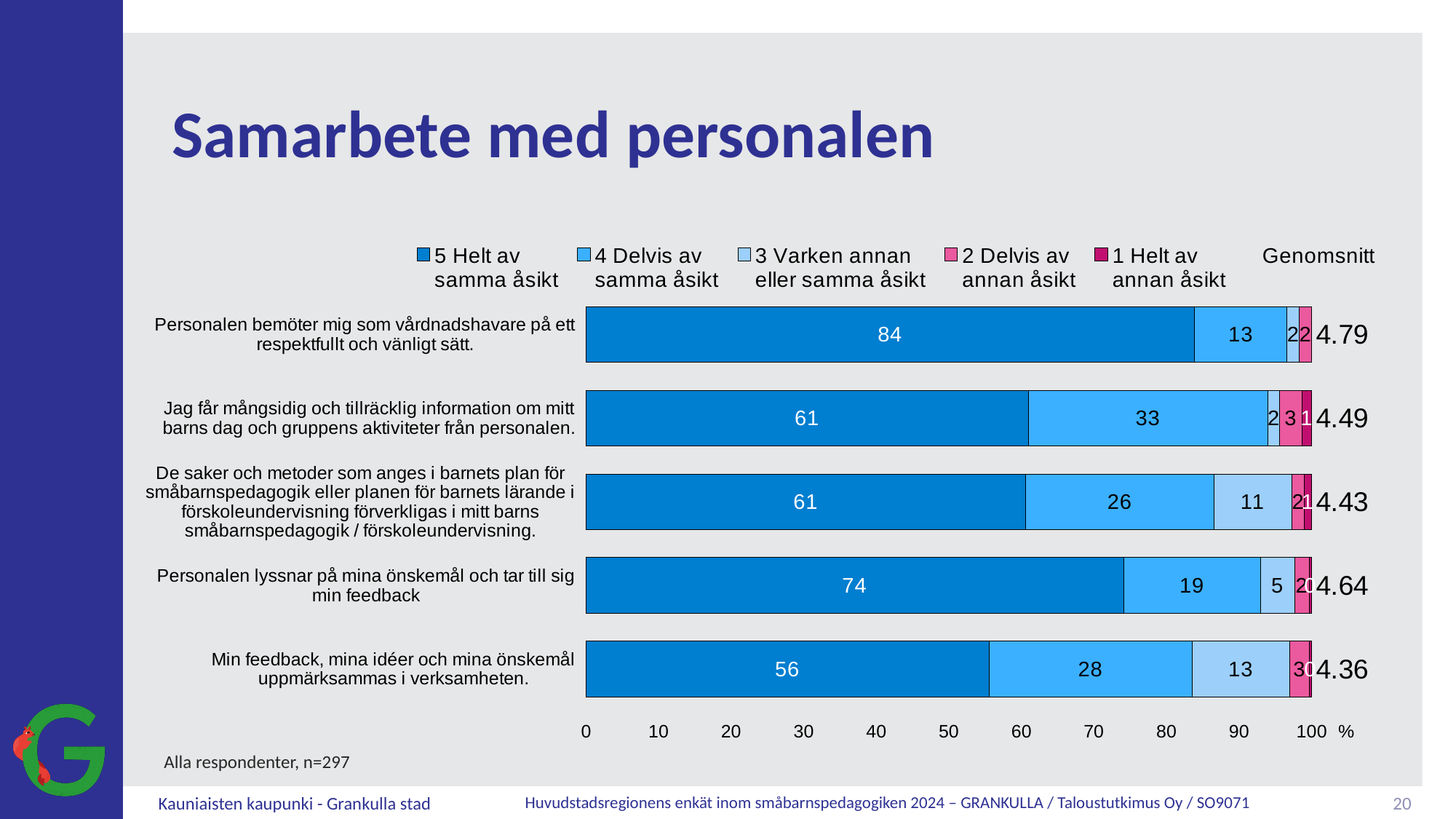
How many opinion levels with coloured boxes does the legend list? 5 How many statements (categories) are plotted in the chart? 5 What is the difference in the '5 Helt av samma åsikt' percentage between 'Personalen bemöter mig som vårdnadshavare...' and 'Min feedback, mina idéer och mina önskemål uppmärksammas i verksamheten.'? 28 Which statement has the lowest Genomsnitt value? Min feedback, mina idéer och mina önskemål uppmärksammas i verksamheten. What percentage answered '3 Varken annan eller samma åsikt' for 'Min feedback, mina idéer och mina önskemål uppmärksammas i verksamheten.'? 13 Which statement has the highest Genomsnitt value? Personalen bemöter mig som vårdnadshavare på ett respektfullt och vänligt sätt. What kind of chart is shown on the slide? bar chart What percentage answered '4 Delvis av samma åsikt' for 'Jag får mångsidig och tillräcklig information om mitt barns dag och gruppens aktiviteter från personalen.'? 33 Which statement has a larger '3 Varken annan eller samma åsikt' share: 'De saker och metoder som anges i barnets plan...' or 'Personalen lyssnar på mina önskemål och tar till sig min feedback'? De saker och metoder som anges i barnets plan för småbarnspedagogik eller planen för barnets lärande i förskoleundervisning förverkligas i mitt barns småbarnspedagogik / förskoleundervisning. How many respondents does the chart cover, according to the note below it? n=297 What percentage of respondents answered '5 Helt av samma åsikt' for 'Personalen bemöter mig som vårdnadshavare på ett respektfullt och vänligt sätt.'? 84 What is the Genomsnitt value for 'Personalen lyssnar på mina önskemål och tar till sig min feedback'? 4.64